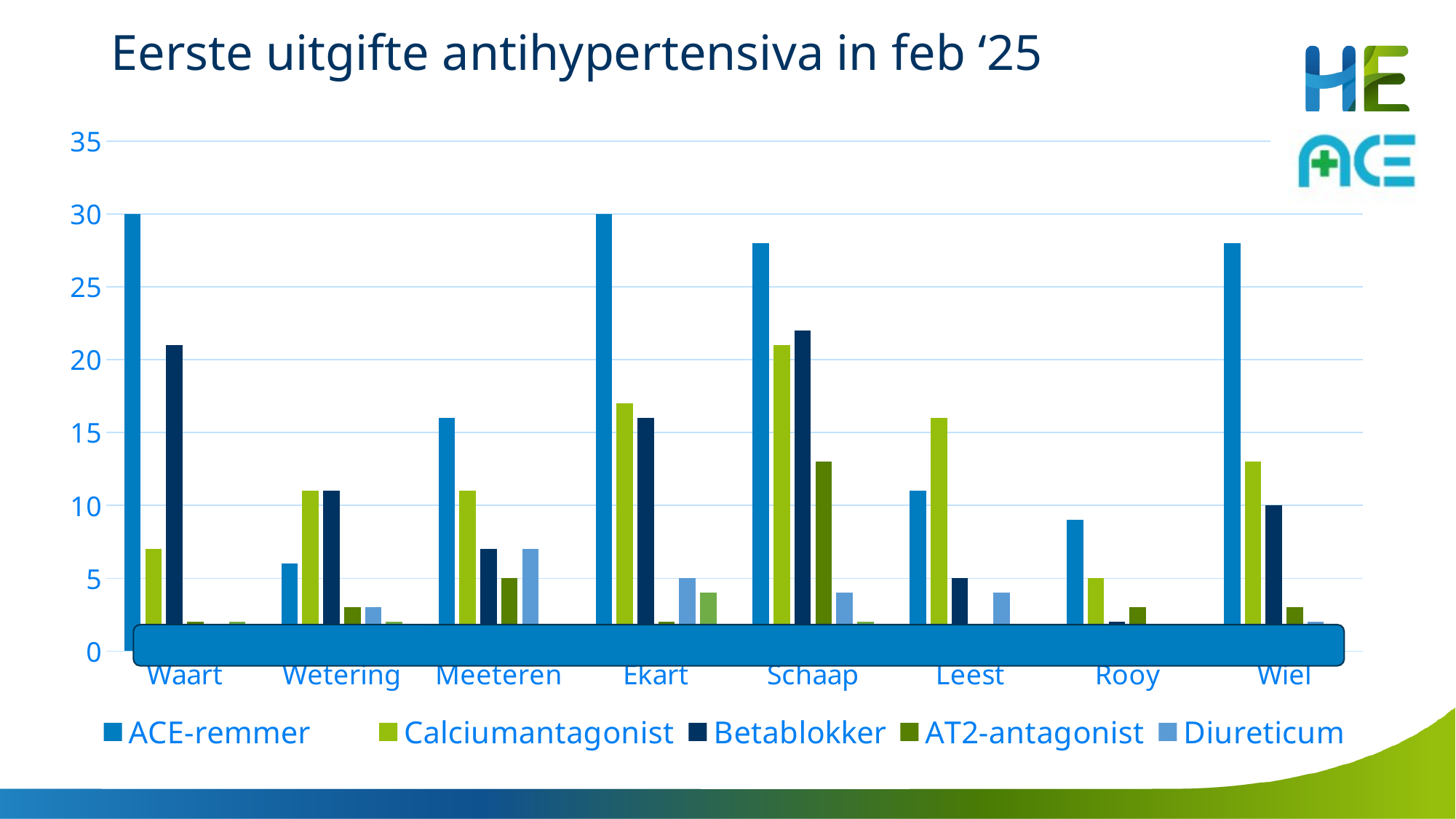
Which category has the highest Calciumantagonist value? Schaap Is the value for ACE-remmer at Schaap greater or less than 25? greater How many series does the legend list? 5 What is the title of the chart? Eerste uitgifte antihypertensiva in feb ‘25 Is the value for ACE-remmer at Rooy greater or less than 10? less At Waart, which is larger: Betablokker or Calciumantagonist? Betablokker How many categories are shown on the x axis? 8 Which category has the lowest ACE-remmer value? Wetering What is the value for ACE-remmer at Ekart? 30 What kind of chart is shown on the slide? bar chart What is the value for Betablokker at Wiel? 10 What is the value for ACE-remmer at Waart? 30